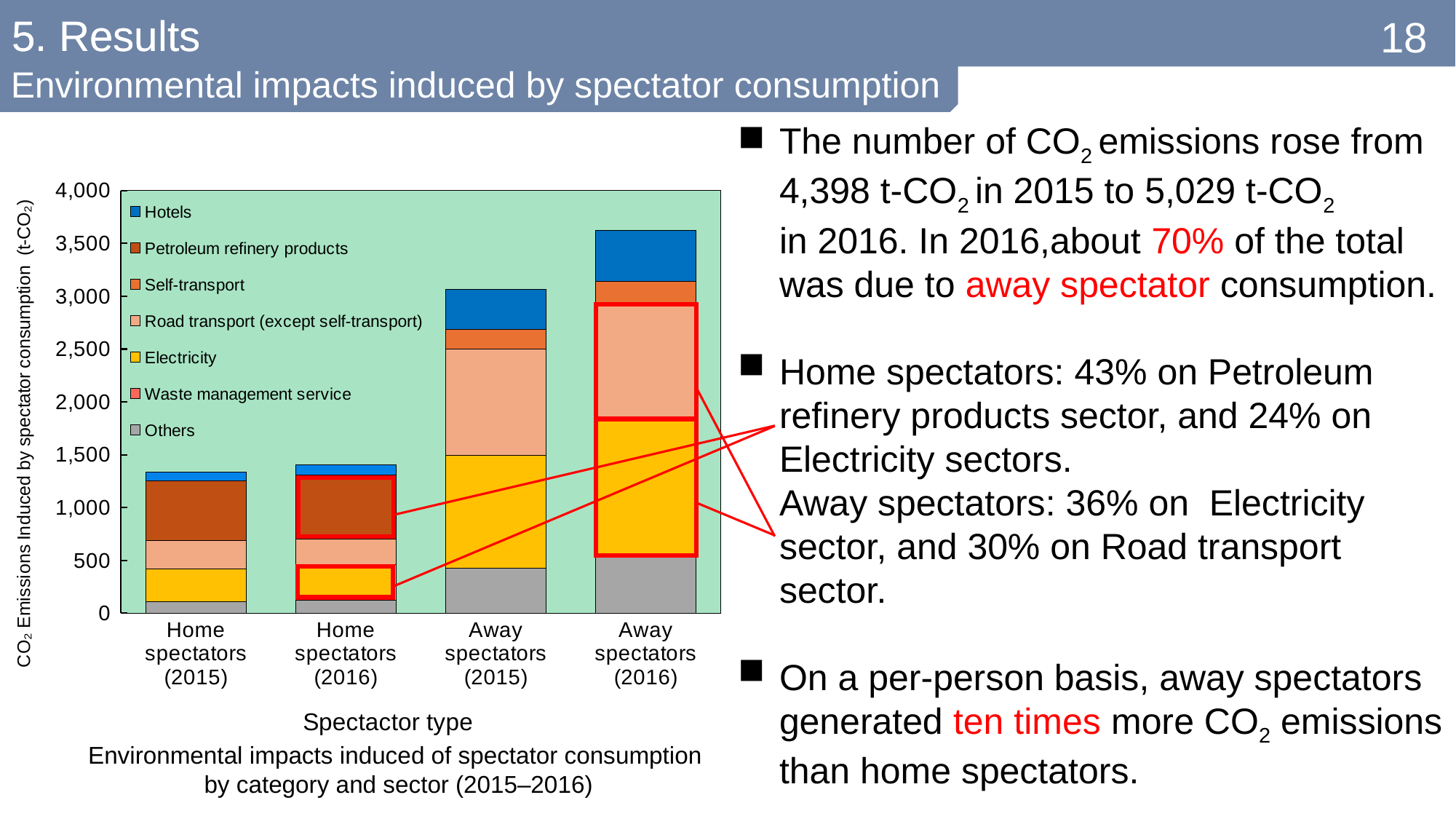
How many spectator-type categories are plotted on the x axis? 4 What kind of chart is shown on the slide? Stacked bar chart What is the label of the y axis? CO2 Emissions Induced by spectator consumption (t-CO2) Which is larger, the total for Away spectators (2015) or Home spectators (2016)? Away spectators (2015) Is the total for Away spectators (2015) greater or less than 3,500? less Is the total for Away spectators (2016) greater or less than 3,500? greater Do the total bar heights rise or fall moving left to right along the x axis? Rise Which colour represents Hotels in the legend? Blue Which spectator type has the highest total CO2 emissions? Away spectators (2016) Is the total for Home spectators (2015) greater or less than 1,500? less How many series does the legend list? 7